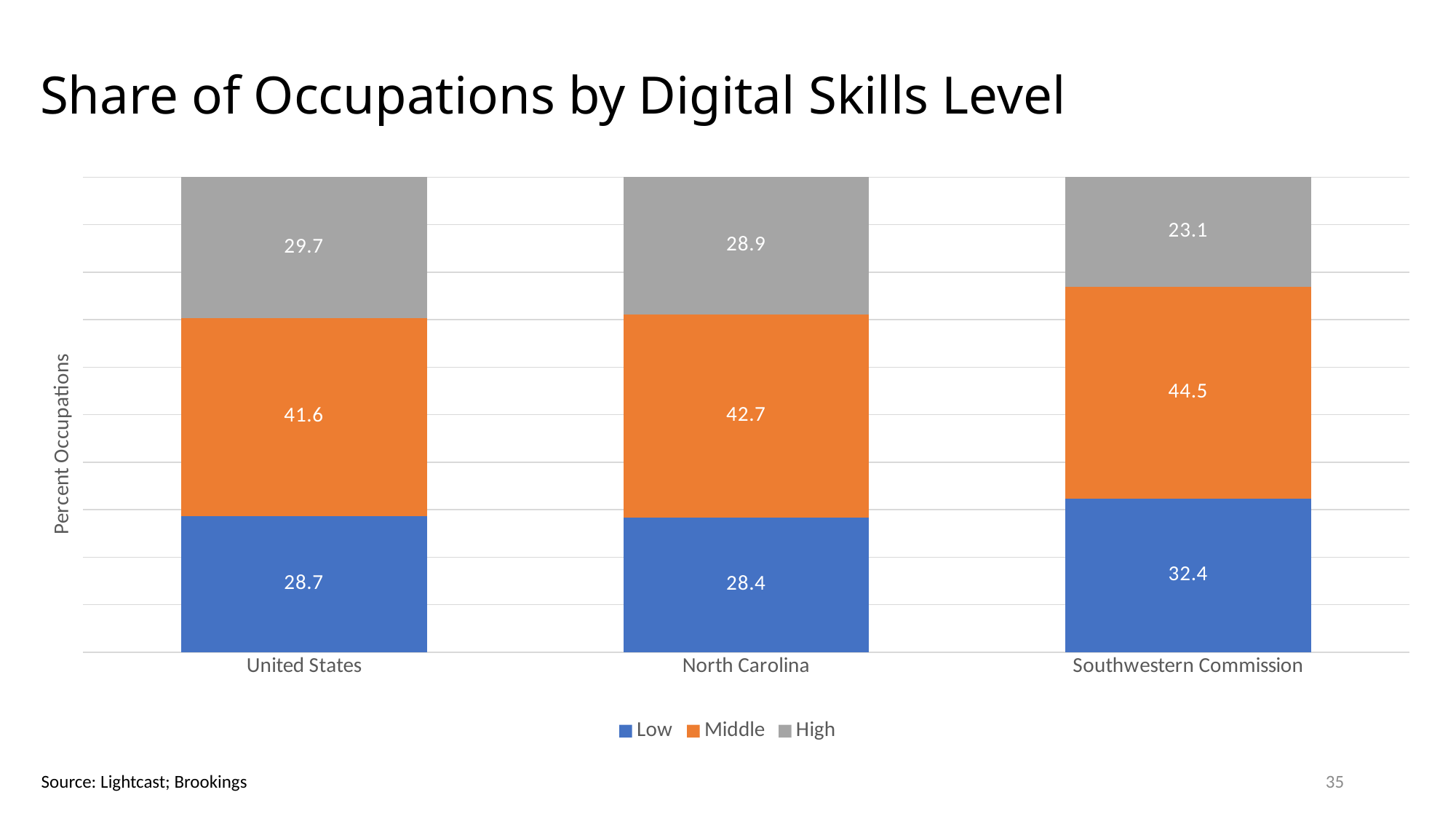
What is the total of the stacked bar for North Carolina? 100.0 Which category has the lowest High value? Southwestern Commission What kind of chart is shown? Stacked bar chart How many categories are shown on the x axis? 3 What is the difference between the High values for the United States and Southwestern Commission? 6.6 What is the Low value for Southwestern Commission? 32.4 Which is larger, the Middle value for North Carolina or the Middle value for the United States? North Carolina What is the High value for North Carolina? 28.9 What is the Middle value for the United States? 41.6 Which category has the highest Middle value? Southwestern Commission What is the title of the chart? Share of Occupations by Digital Skills Level How many series does the legend list? 3